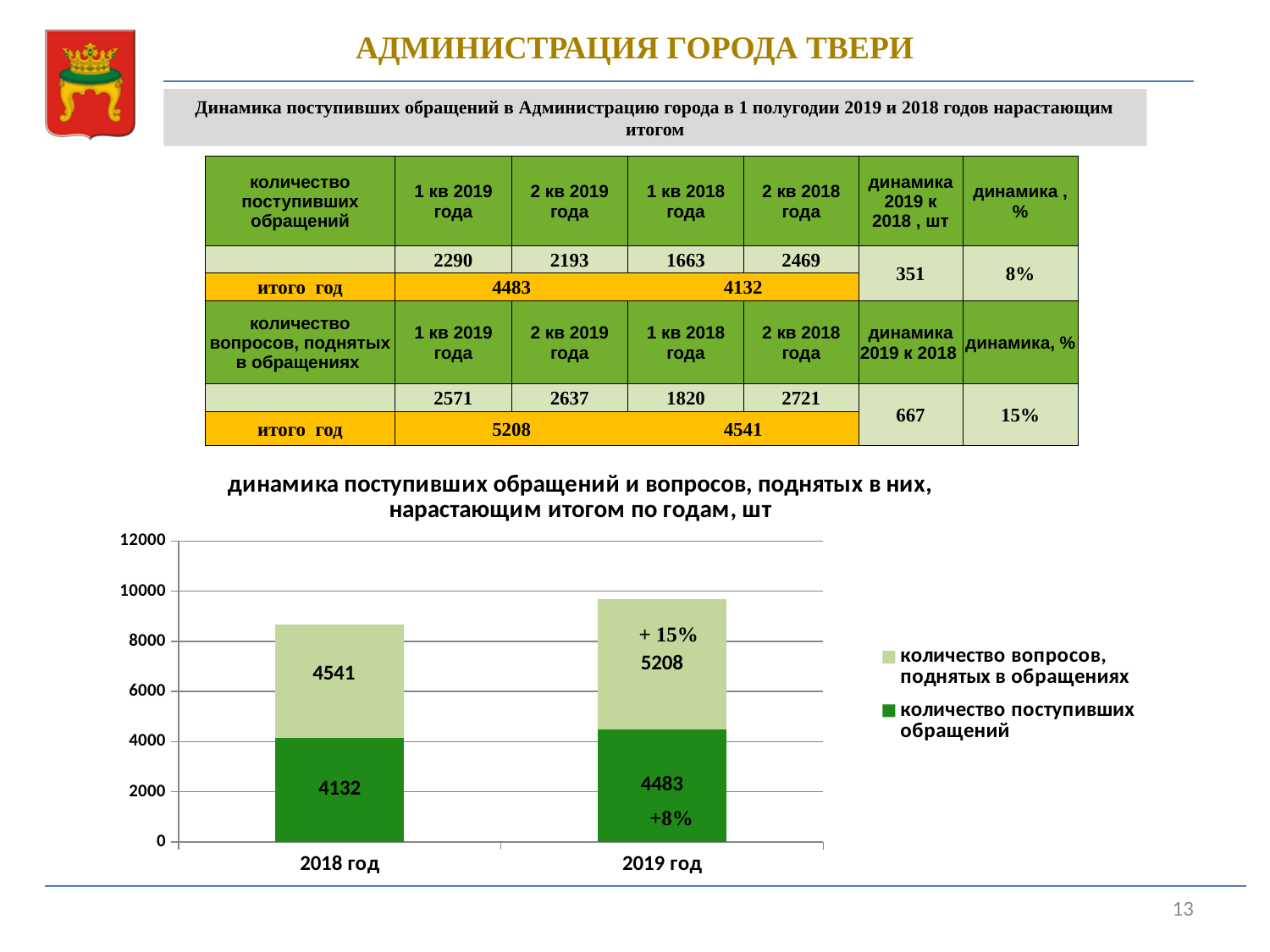
How many series does the chart legend list? 2 What is the value of "количество вопросов, поднятых в обращениях" for 2018 год? 4541 What is the value of "количество вопросов, поднятых в обращениях" for 2019 год? 5208 Does the total height of the stacked bars rise or fall from 2018 год to 2019 год? rise What is the difference between "количество вопросов, поднятых в обращениях" in 2019 год and 2018 год? 667 What kind of chart is shown on the slide? stacked bar chart What is the value of "количество поступивших обращений" for 2018 год? 4132 What is the value of "количество поступивших обращений" for 2019 год? 4483 What is the total of the stacked bar for 2019 год? 9691 What is the total of the stacked bar for 2018 год? 8673 How many categories are shown on the x axis of the chart? 2 Which year has the larger value for "количество поступивших обращений", 2018 год or 2019 год? 2019 год